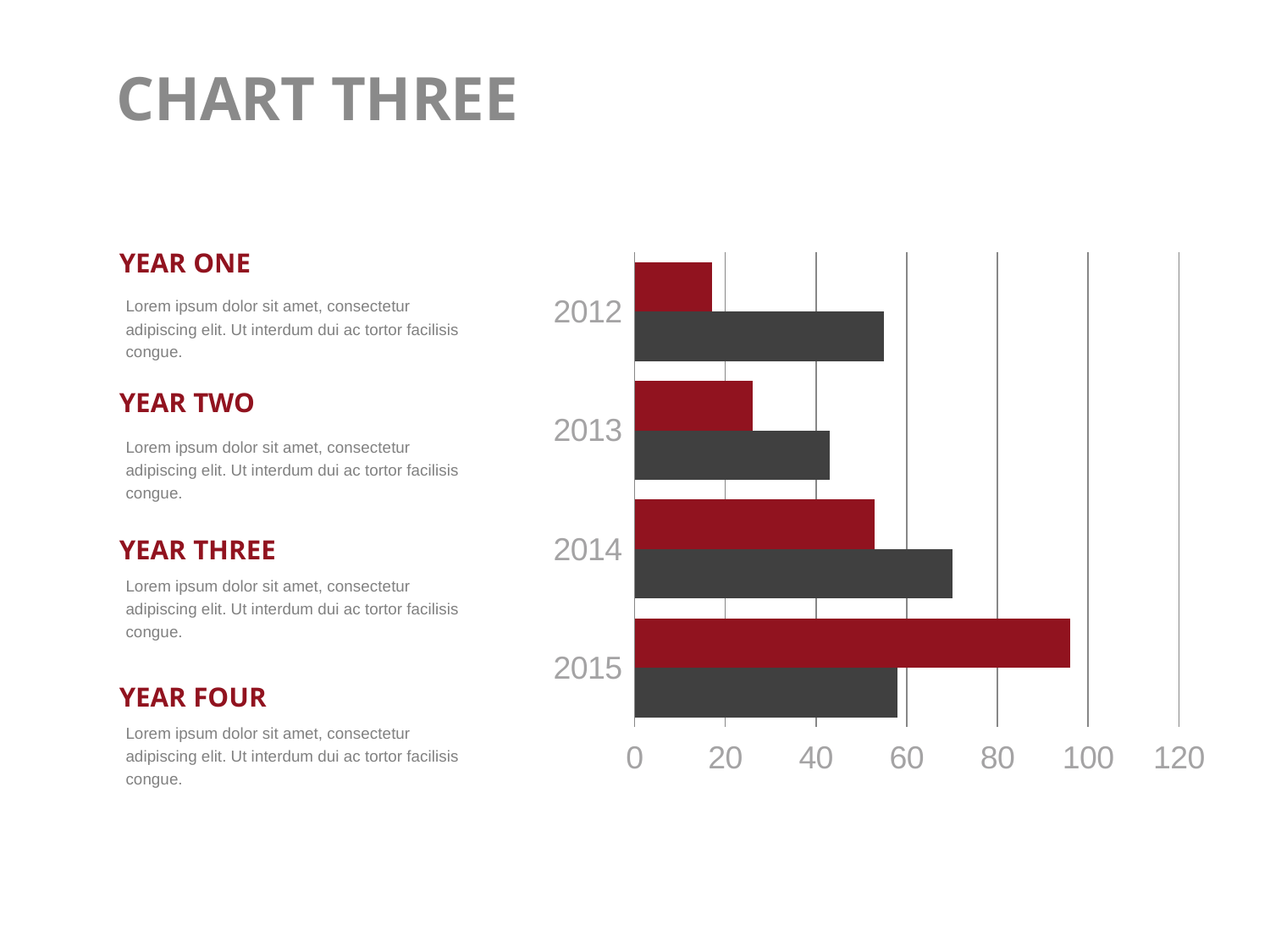
Is the red bar for 2015 greater or less than 80? greater Which year has the shortest red bar? 2012 Which year has the shortest dark grey bar? 2013 For 2015, which bar is longer, the red bar or the dark grey bar? the red bar Which year has the longest dark grey bar? 2014 Which year has the longest red bar? 2015 Is the dark grey bar for 2014 greater or less than 60? greater Do the red bars get longer or shorter from 2012 to 2015? longer How many categories (years) are shown on the chart? 4 What kind of chart is shown on the slide? bar chart How many bars are plotted for each year on the chart? 2 Is the red bar for 2012 greater or less than 20? less